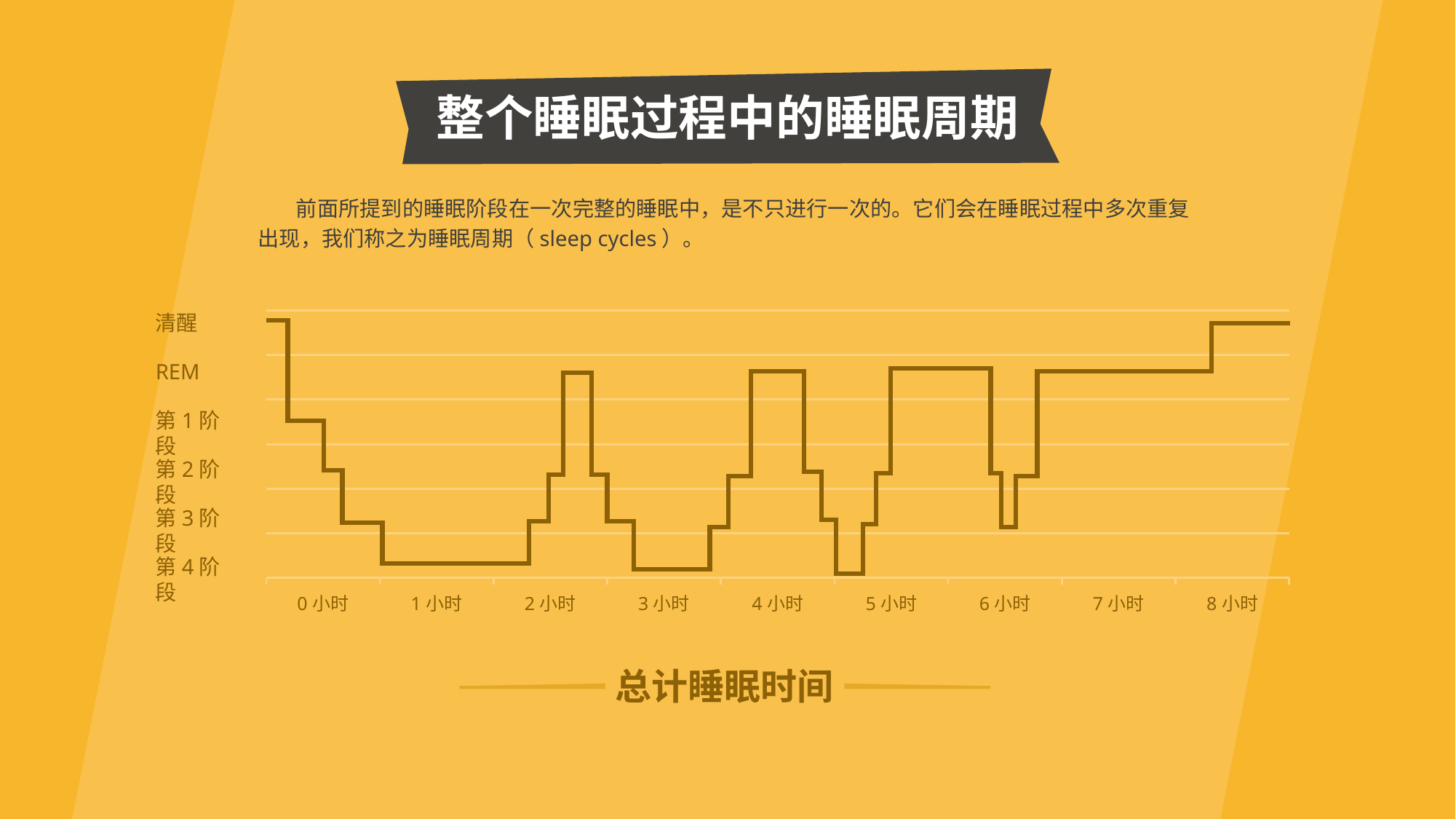
What is the label shown beneath the x axis of the chart? 总计睡眠时间 What is the title of the chart on the slide? 整个睡眠过程中的睡眠周期 Which sleep stage is the line at throughout the 1 小时 interval? 第 4 阶段 How many sleep-stage labels are shown on the y axis of the chart? 6 How many hour labels are shown along the x axis of the chart? 9 Which sleep stage is the line at when the chart ends? 清醒 What is the deepest sleep stage the line reaches in the chart? 第 4 阶段 Which sleep stage is the line at throughout the 7 小时 interval? REM What kind of chart is shown on the slide? Line chart Which sleep stage is the line at when the chart begins? 清醒 How many times does the line drop down to 第 4 阶段 during the night? 3